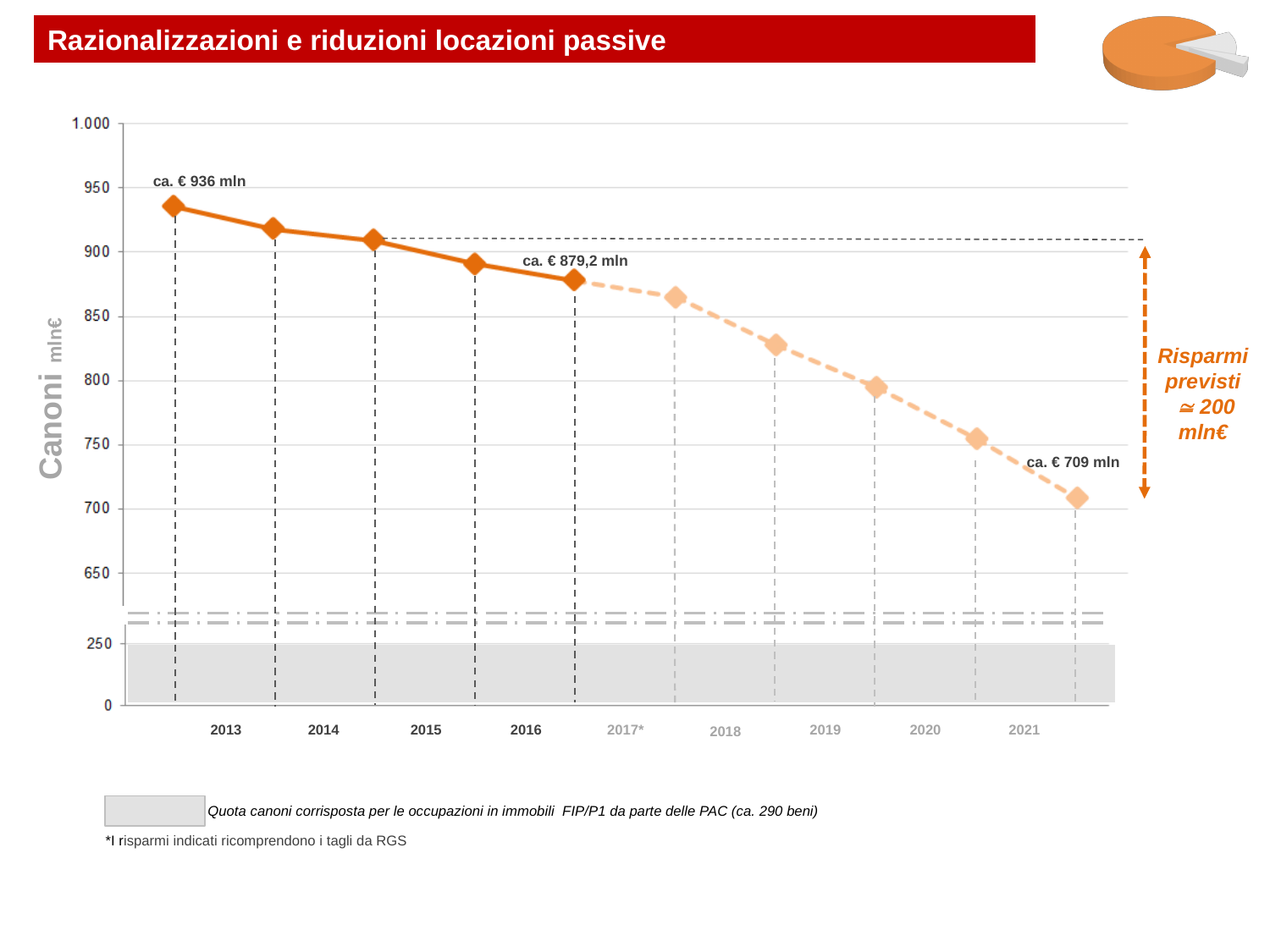
Is the value for 2014 greater or less than 900? greater Which year has the highest value? 2013 Do the values rise or fall from 2013 to 2021? fall Which year has the lowest value? 2021 What kind of chart is shown? line chart What value is labelled for 2021? ca. € 709 mln What is the title of the y axis? Canoni mln€ Which is larger, the value for 2013 or the value for 2021? 2013 How many years are plotted on the x axis? 9 Is the value for 2018 greater or less than 850? less What value is labelled for 2013? ca. € 936 mln